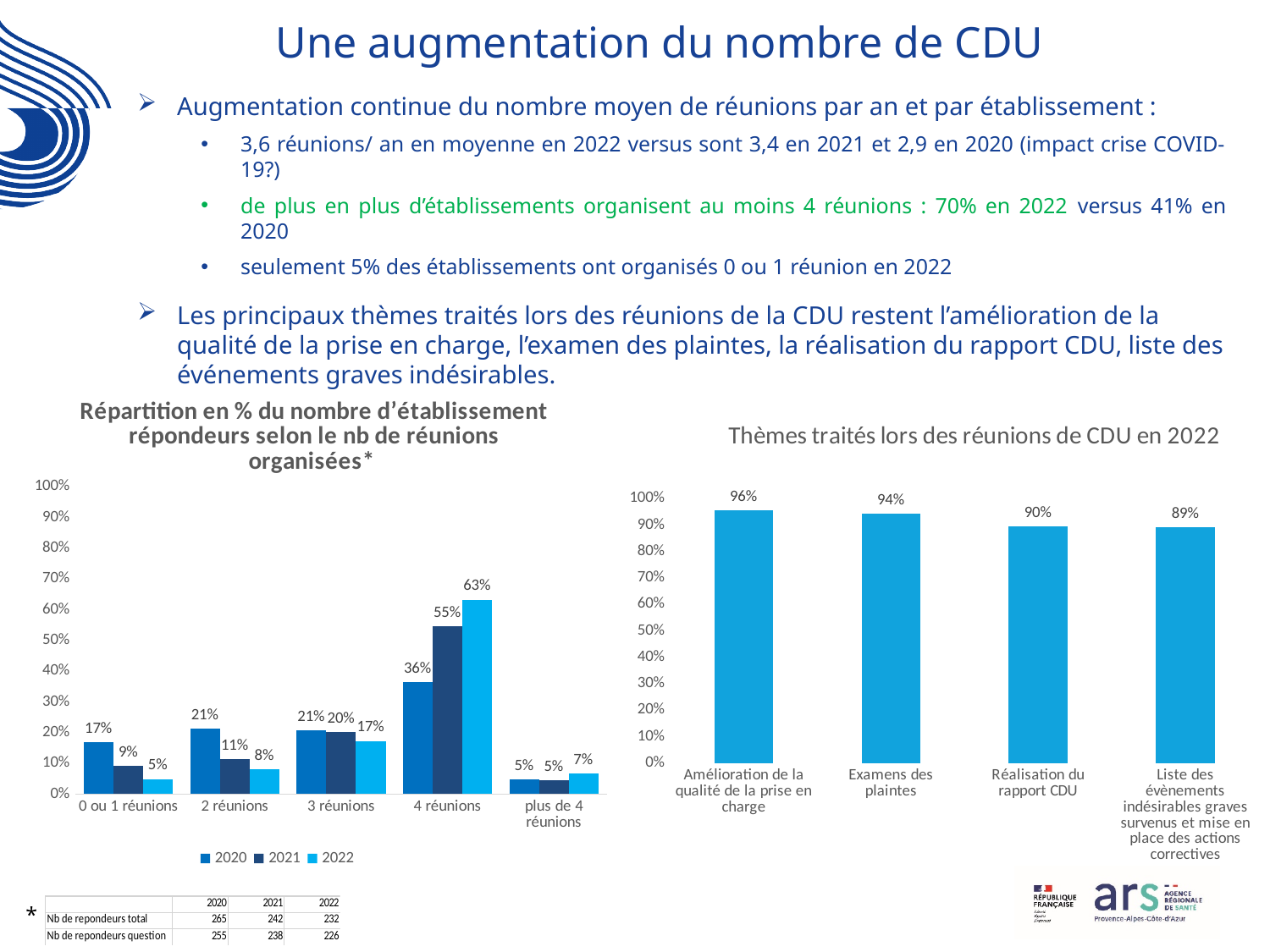
In the chart 'Répartition en % du nombre d'établissement répondeurs selon le nb de réunions organisées', which category has the highest value for the 2021 series? 4 réunions In the chart 'Répartition en % du nombre d'établissement répondeurs selon le nb de réunions organisées', what is the difference between the 2022 and 2020 values for '4 réunions'? 27% In the chart 'Répartition en % du nombre d'établissement répondeurs selon le nb de réunions organisées', how many categories are shown on the x axis? 5 In the chart 'Répartition en % du nombre d'établissement répondeurs selon le nb de réunions organisées', which is larger for '2 réunions': the 2020 value or the 2021 value? 2020 In the chart 'Répartition en % du nombre d'établissement répondeurs selon le nb de réunions organisées', what is the value for 2022 in the '4 réunions' category? 63% In the chart 'Répartition en % du nombre d'établissement répondeurs selon le nb de réunions organisées', what is the value for 2020 in the '0 ou 1 réunions' category? 17% In the chart 'Thèmes traités lors des réunions de CDU en 2022', which theme has the lowest value? Liste des évènements indésirables graves survenus et mise en place des actions correctives In the chart 'Thèmes traités lors des réunions de CDU en 2022', what is the value for 'Examens des plaintes'? 94% In the chart 'Répartition en % du nombre d'établissement répondeurs selon le nb de réunions organisées', how many series does the legend list? 3 What kind of chart is 'Thèmes traités lors des réunions de CDU en 2022'? bar chart In the chart 'Thèmes traités lors des réunions de CDU en 2022', what is the difference between 'Amélioration de la qualité de la prise en charge' and 'Réalisation du rapport CDU'? 6% In the chart 'Thèmes traités lors des réunions de CDU en 2022', do the values rise or fall from left to right along the x axis? fall